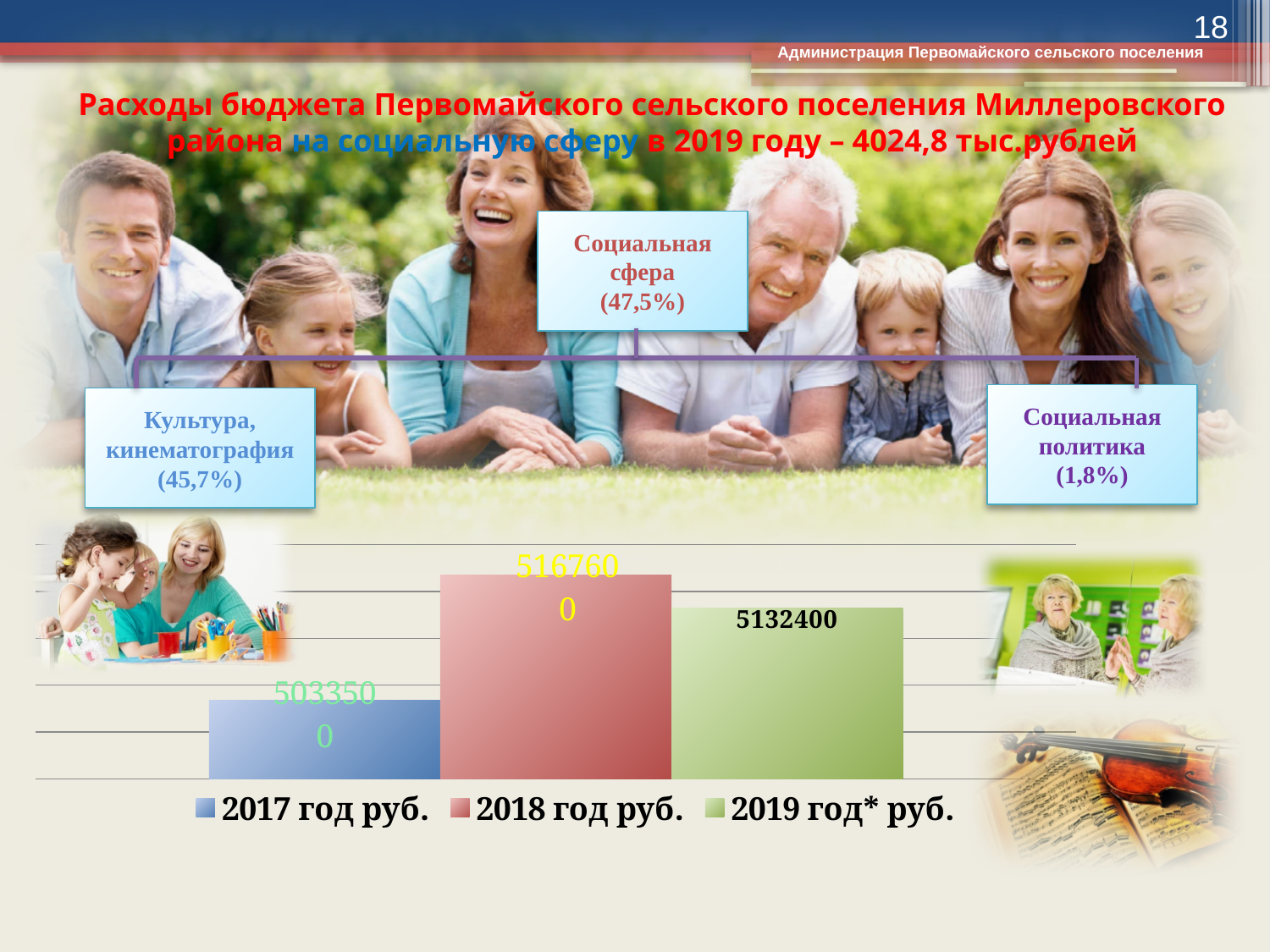
What is the value for 2017 год руб. in the bar chart? 5033500 What is the value for 2019 год* руб. in the bar chart? 5132400 How many series does the legend of the bar chart list? 3 What colour is the bar for 2018 год руб. in the chart? red What is the difference between the values for 2018 год руб. and 2019 год* руб.? 35200 Which is larger, the value for 2019 год* руб. or the value for 2017 год руб.? 2019 год* руб. Which year has the lowest value in the bar chart? 2017 год руб. Which year has the highest value in the bar chart? 2018 год руб. What is the value for 2018 год руб. in the bar chart? 5167600 Does the value rise or fall from 2018 год руб. to 2019 год* руб.? fall What is the difference between the values for 2018 год руб. and 2017 год руб.? 134100 What kind of chart is shown on the slide? bar chart